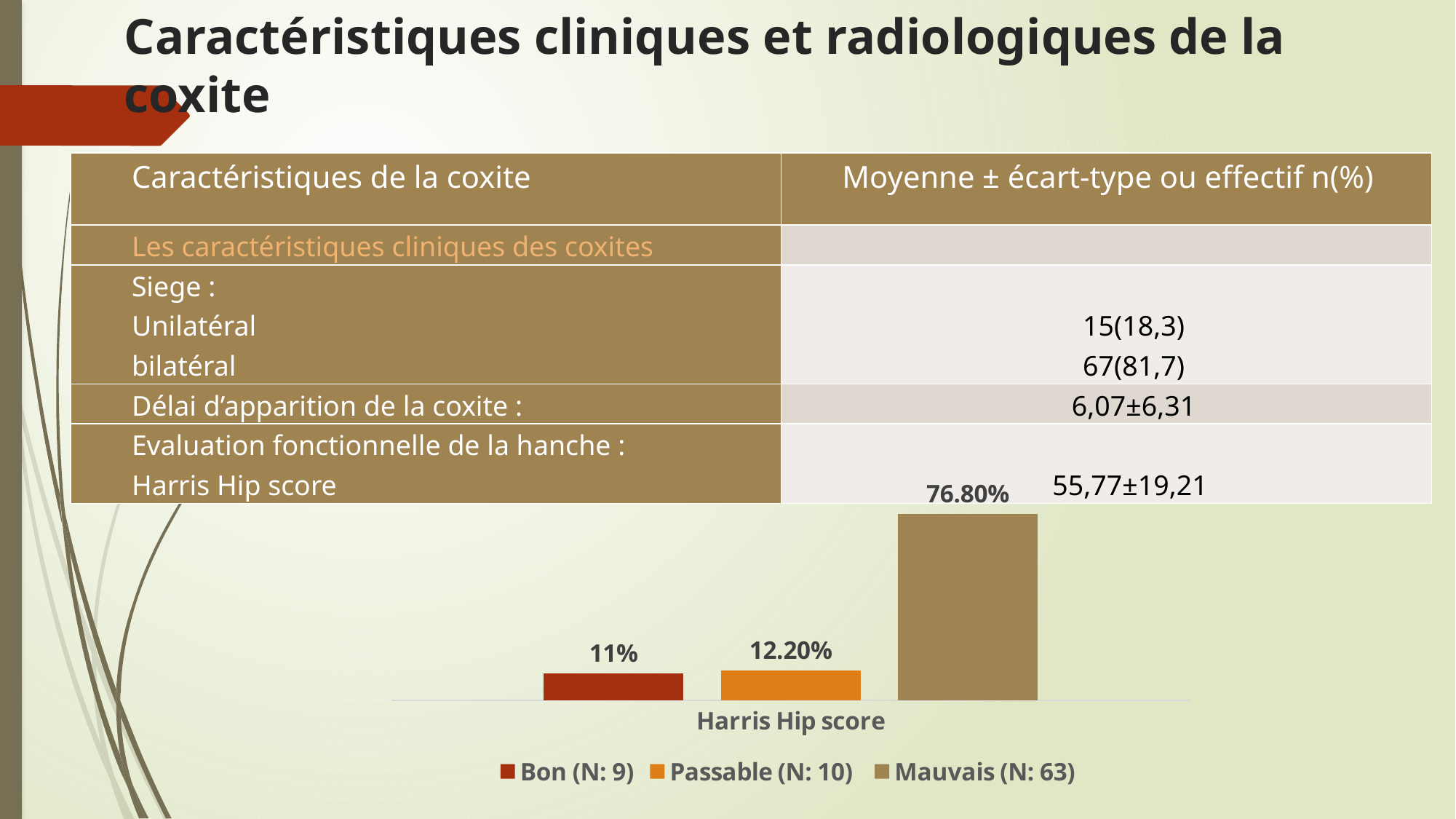
How many categories are shown on the x axis of the bar chart? 1 Which is larger in the Harris Hip score chart, Bon (N: 9) or Mauvais (N: 63)? Mauvais (N: 63) What is the value for Bon (N: 9) in the Harris Hip score chart? 11% What is the value for Mauvais (N: 63) in the Harris Hip score chart? 76.80% How many series does the legend of the Harris Hip score chart list? 3 Which series has the lowest value in the Harris Hip score chart? Bon (N: 9) What is the category label on the x axis of the bar chart? Harris Hip score What type of chart is shown at the bottom of the slide? bar chart What is the difference between the Passable (N: 10) and Bon (N: 9) values in the Harris Hip score chart? 1.20% Which series has the highest value in the Harris Hip score chart? Mauvais (N: 63) What is the value for Passable (N: 10) in the Harris Hip score chart? 12.20% What is the difference between the Mauvais (N: 63) and Passable (N: 10) values in the Harris Hip score chart? 64.60%